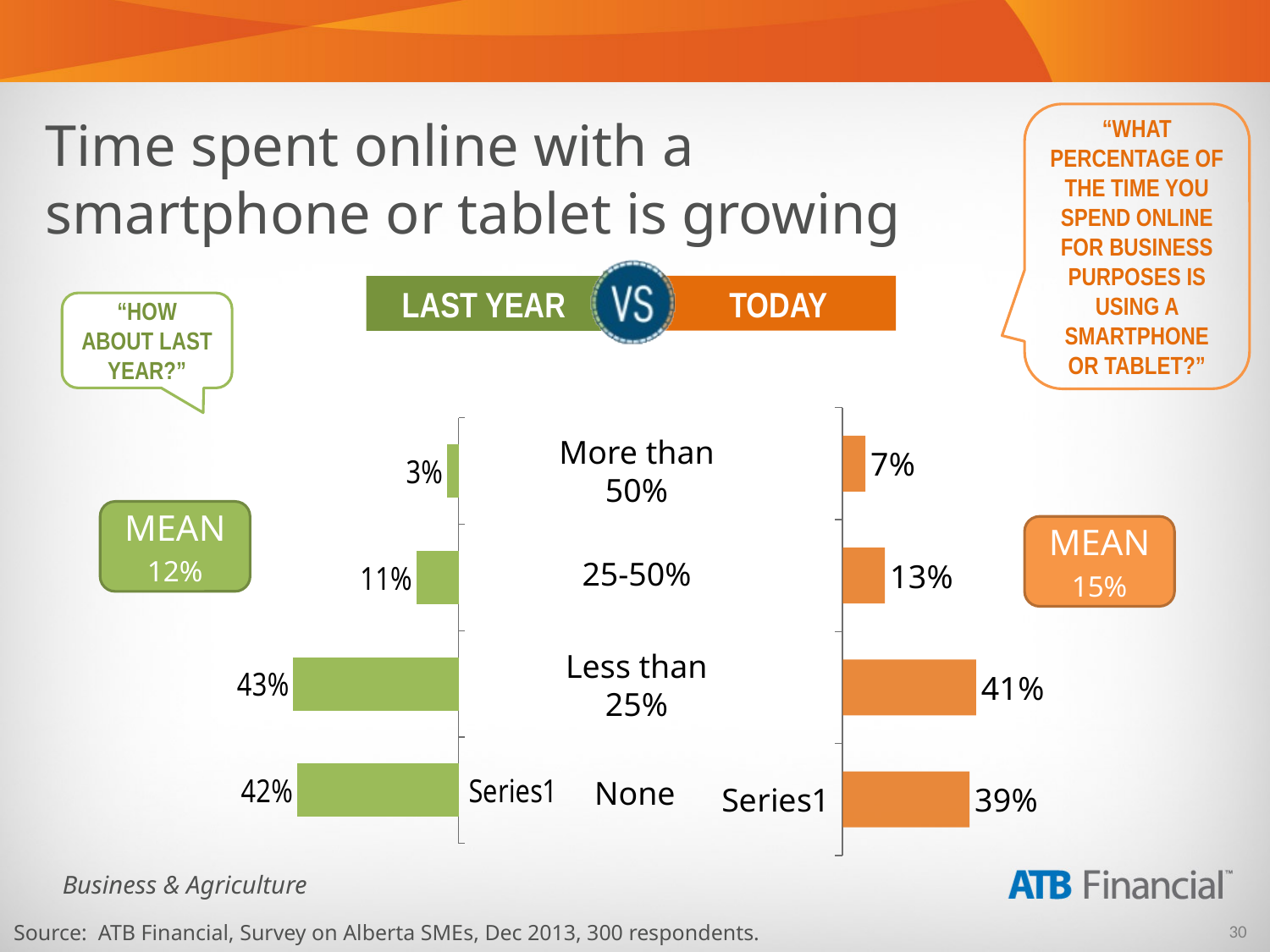
In the Last Year chart, what is the difference between the Less than 25% value and the 25-50% value? 32% What is the mean value shown for Today? 15% How many categories are shown in each of the two bar charts? 4 What type of chart is used to show the Last Year and Today data? Bar chart In the Last Year chart, which category has the highest value? Less than 25% What colour are the bars in the Last Year chart? Green What is the difference between the Today and Last Year values for the More than 50% category? 4% In the Last Year chart, what percentage of respondents spend more than 50% of their online business time on a smartphone or tablet? 3% In the Today chart, which category has the lowest value? More than 50% In the Today chart, what is the value for None? 39% In the Today chart, what is the value for the 25-50% category? 13% Which is larger: the Last Year value for None or the Today value for None? Last Year (42%)